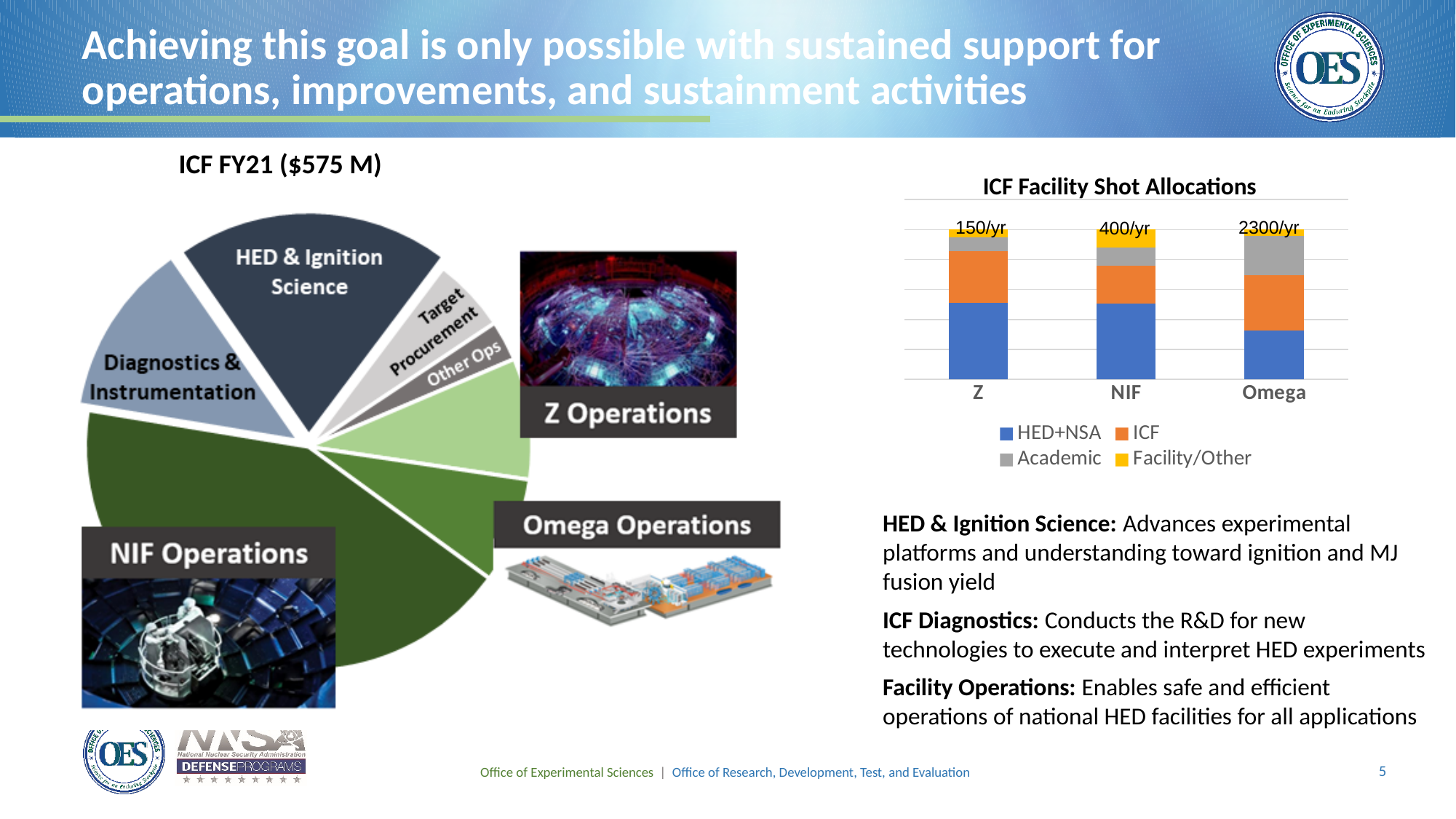
In the 'ICF Facility Shot Allocations' chart, what annual shot allocation is labelled above the Z bar? 150/yr How many slices does the 'ICF FY21 ($575 M)' pie chart have? 7 What kind of chart is the 'ICF Facility Shot Allocations' chart on the right? stacked bar chart In the 'ICF Facility Shot Allocations' chart, what annual shot allocation is labelled above the Omega bar? 2300/yr How many facilities are shown on the x axis of the 'ICF Facility Shot Allocations' chart? 3 What kind of chart is the 'ICF FY21 ($575 M)' chart on the left? pie chart In the 'ICF Facility Shot Allocations' chart, which facility has the larger HED+NSA segment: Z or Omega? Z In the 'ICF FY21 ($575 M)' pie chart, which is larger: the NIF Operations slice or the Z Operations slice? NIF Operations In the 'ICF FY21 ($575 M)' pie chart, which slice is the largest? NIF Operations How many series does the legend of the 'ICF Facility Shot Allocations' chart list? 4 In the 'ICF Facility Shot Allocations' chart, what annual shot allocation is labelled above the NIF bar? 400/yr In the 'ICF Facility Shot Allocations' chart, which colour represents the ICF series in the legend? orange